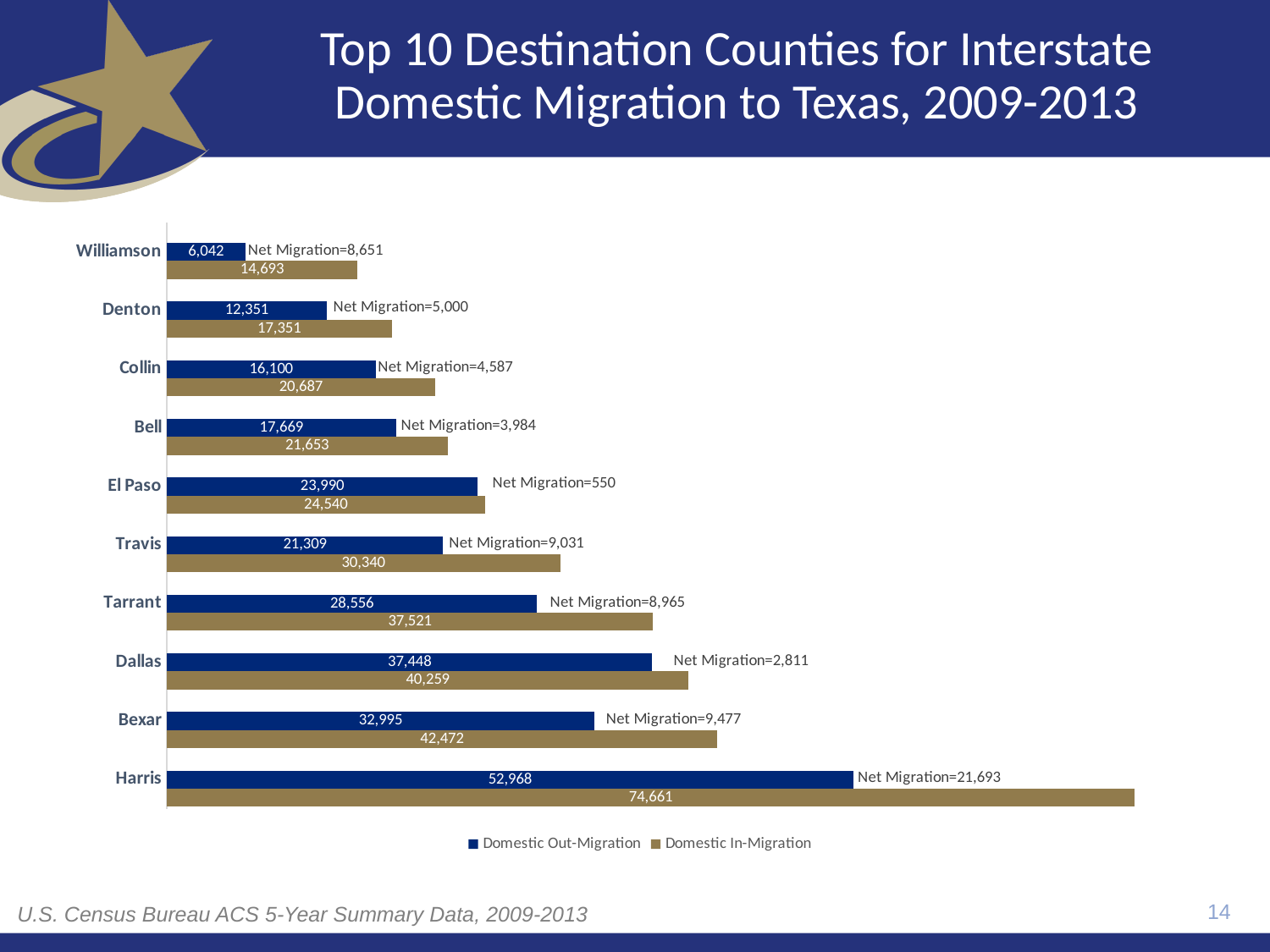
What net migration figure is shown next to the bars for El Paso? Net Migration=550 What is the difference between Domestic In-Migration and Domestic Out-Migration for Dallas County? 2,811 How many counties are shown in the chart? 10 What is the Domestic In-Migration value for Harris County? 74,661 Which county has the lowest Domestic Out-Migration value? Williamson What is the Domestic In-Migration value for Williamson County? 14,693 What is the difference between Domestic In-Migration and Domestic Out-Migration for Travis County? 9,031 What is the Domestic Out-Migration value for Bexar County? 32,995 What kind of chart is shown on the slide? Bar chart Which county has the highest Domestic In-Migration value? Harris How many series does the legend list? 2 Which is larger: the Domestic In-Migration value for El Paso or for Bell? El Paso